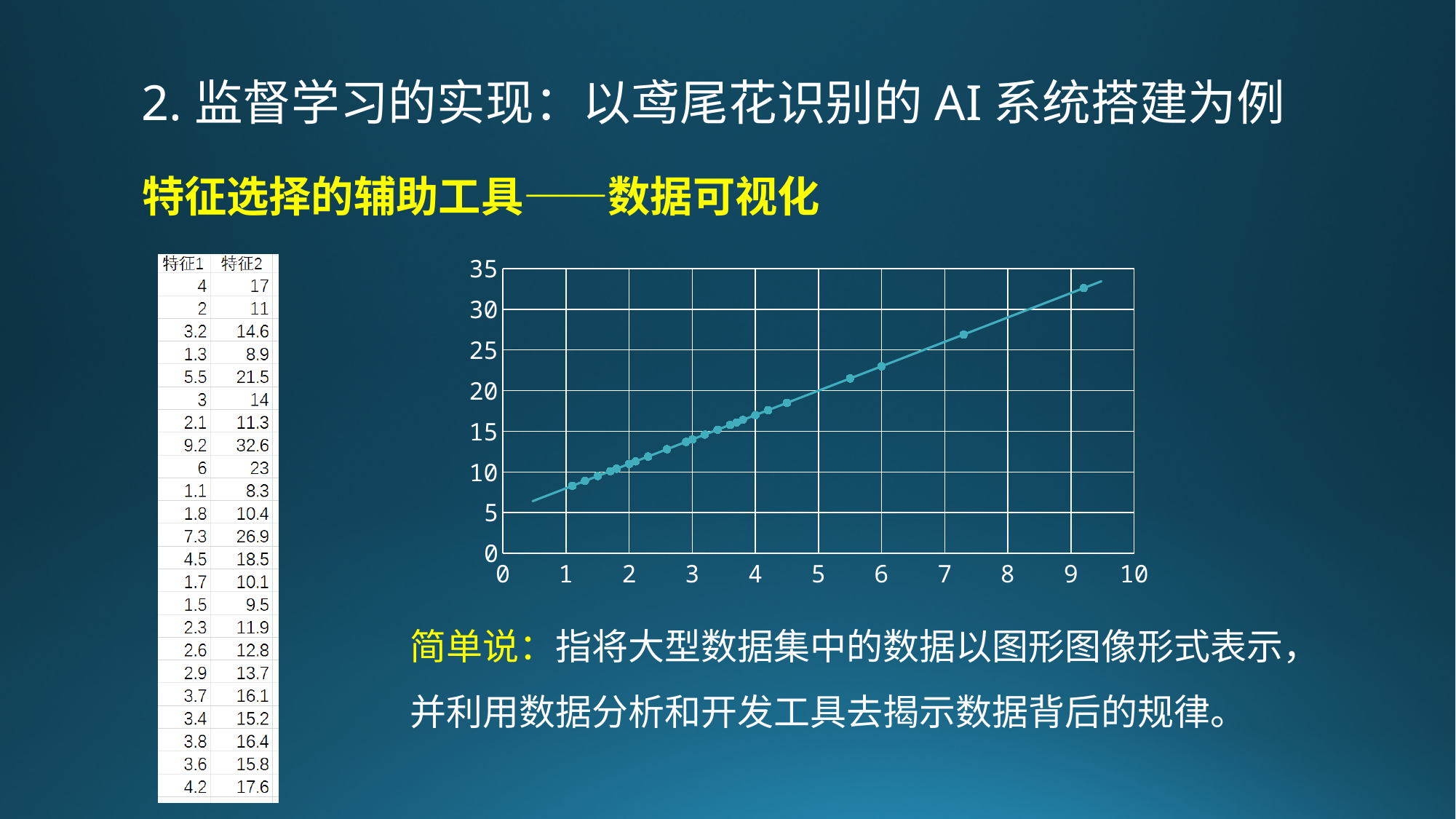
According to the table, which 特征1 value has the lowest 特征2 value? 1.1 Is the value of the point plotted at x = 6 greater or less than 20? greater Is the value of the point plotted at x = 1.1 greater or less than 10? less How many data rows does the table on the slide contain? 23 According to the table on the slide, what is the 特征2 value when 特征1 is 9.2? 32.6 According to the table, which 特征1 value has the highest 特征2 value? 9.2 What is the maximum value shown on the chart's vertical axis? 35 Do the plotted values rise or fall as the x-axis value increases? rise Is the value of the point plotted at x = 7.3 greater or less than 25? greater What kind of chart is shown on the slide? scatter chart According to the table on the slide, what is the 特征2 value when 特征1 is 5.5? 21.5